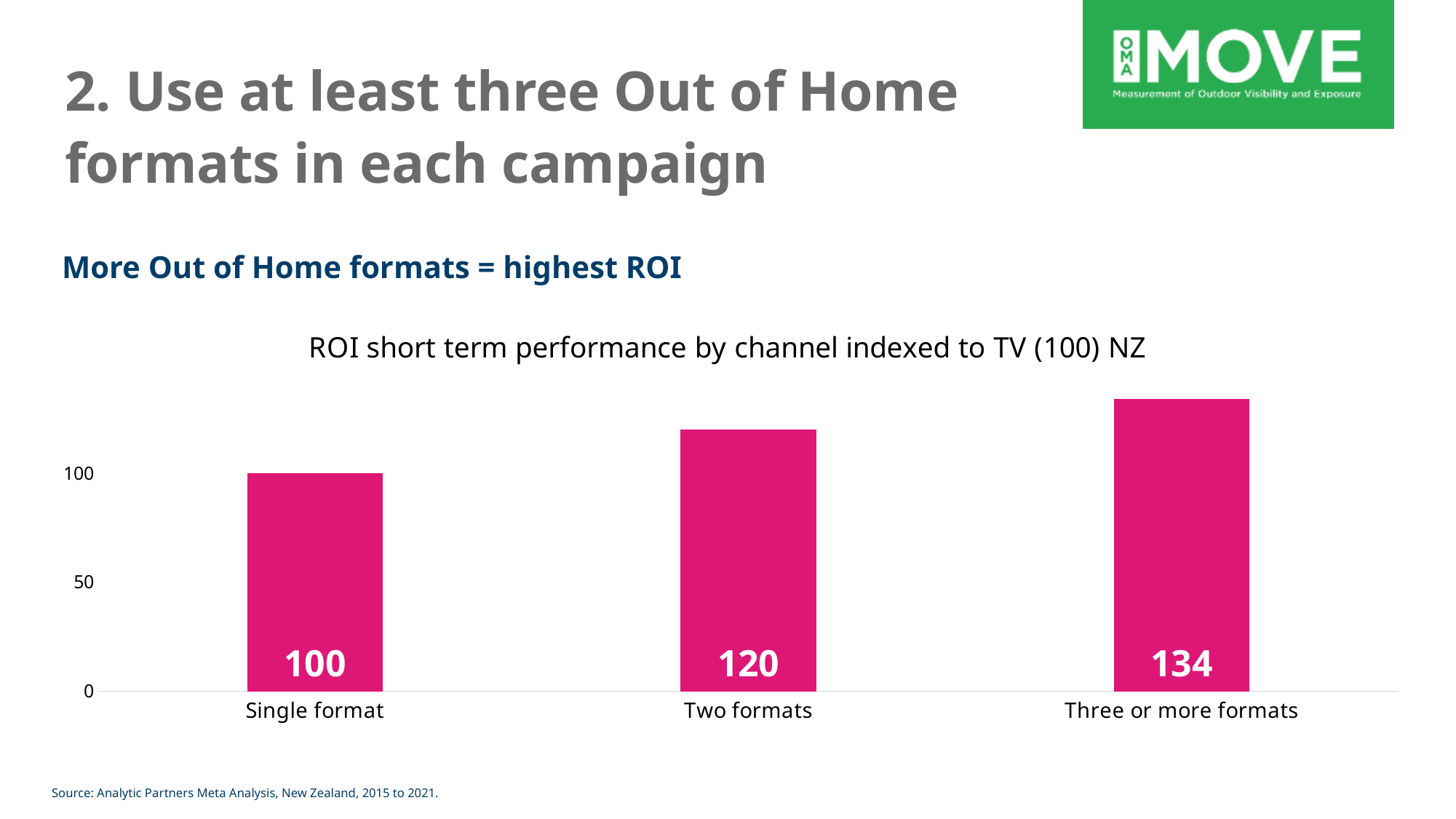
What is the difference between the values for Two formats and Single format? 20 What kind of chart is shown on the slide? Bar chart Which category has the lowest value? Single format How many categories are shown on the chart? 3 What is the value for Three or more formats? 134 Which is larger, the value for Two formats or the value for Three or more formats? Three or more formats What is the value for Single format? 100 What is the value for Two formats? 120 Is the value for Two formats greater or less than 100? greater What is the difference between the values for Three or more formats and Single format? 34 Do the values rise or fall from Single format to Three or more formats? Rise Which category has the highest value? Three or more formats